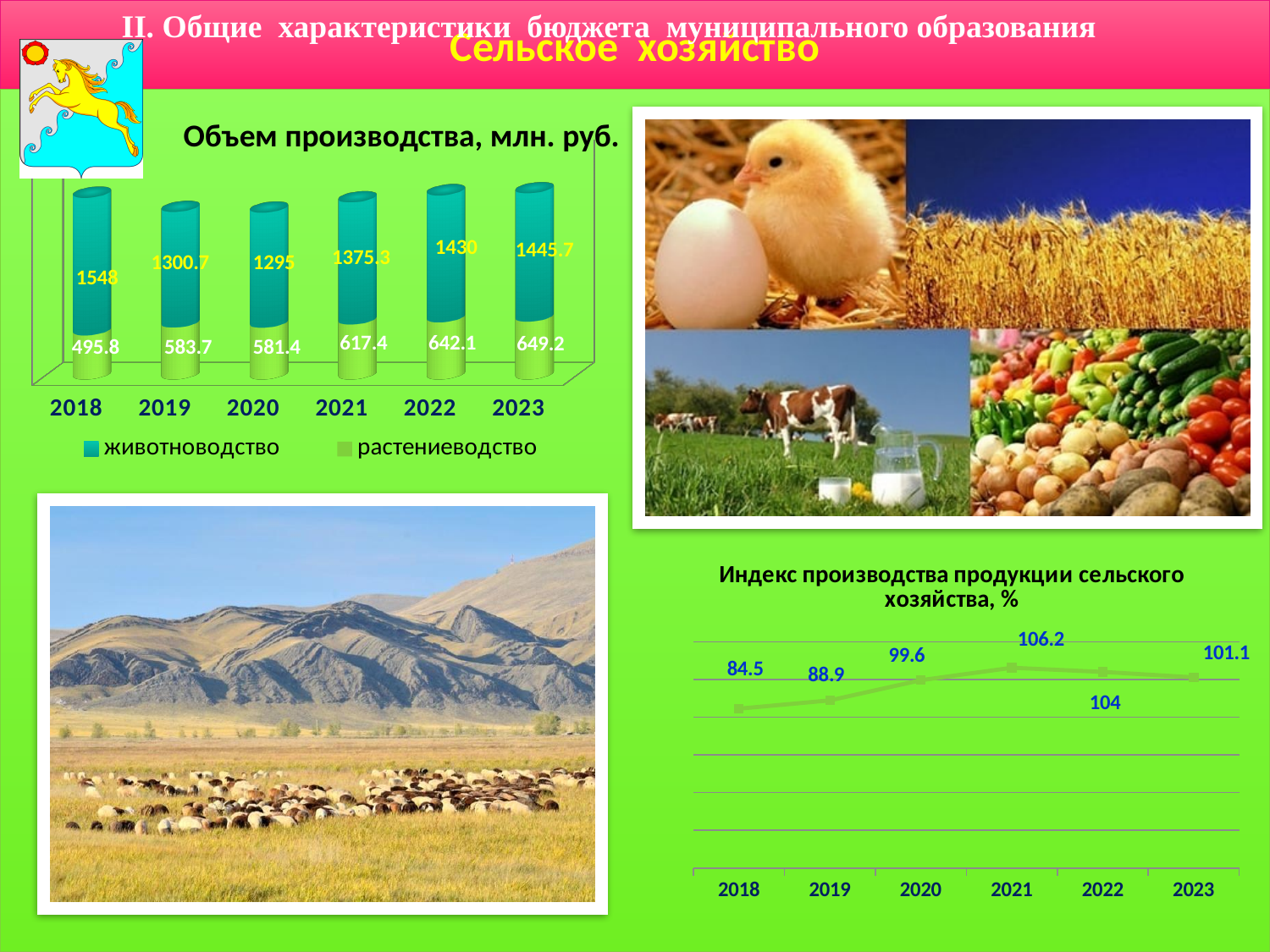
What type of chart is 'Объем производства, млн. руб.'? bar chart In the chart 'Индекс производства продукции сельского хозяйства, %', which year has the lowest value? 2018 How many series does the legend of the chart 'Объем производства, млн. руб.' list? 2 In the chart 'Объем производства, млн. руб.', what is the difference between the растениеводство values for 2022 and 2021? 24.7 In the chart 'Объем производства, млн. руб.', what is the value for животноводство in 2018? 1548 In the chart 'Индекс производства продукции сельского хозяйства, %', is the value for 2022 larger or smaller than the value for 2023? larger In the chart 'Объем производства, млн. руб.', what is the value for растениеводство in 2023? 649.2 In the chart 'Объем производства, млн. руб.', which year has the lowest value for растениеводство? 2018 In the chart 'Индекс производства продукции сельского хозяйства, %', what is the value for 2021? 106.2 In the chart 'Объем производства, млн. руб.', what is the total of the stacked bar for 2023? 2094.9 How many data points are plotted in the chart 'Индекс производства продукции сельского хозяйства, %'? 6 In the chart 'Объем производства, млн. руб.', which year has the highest value for животноводство? 2018